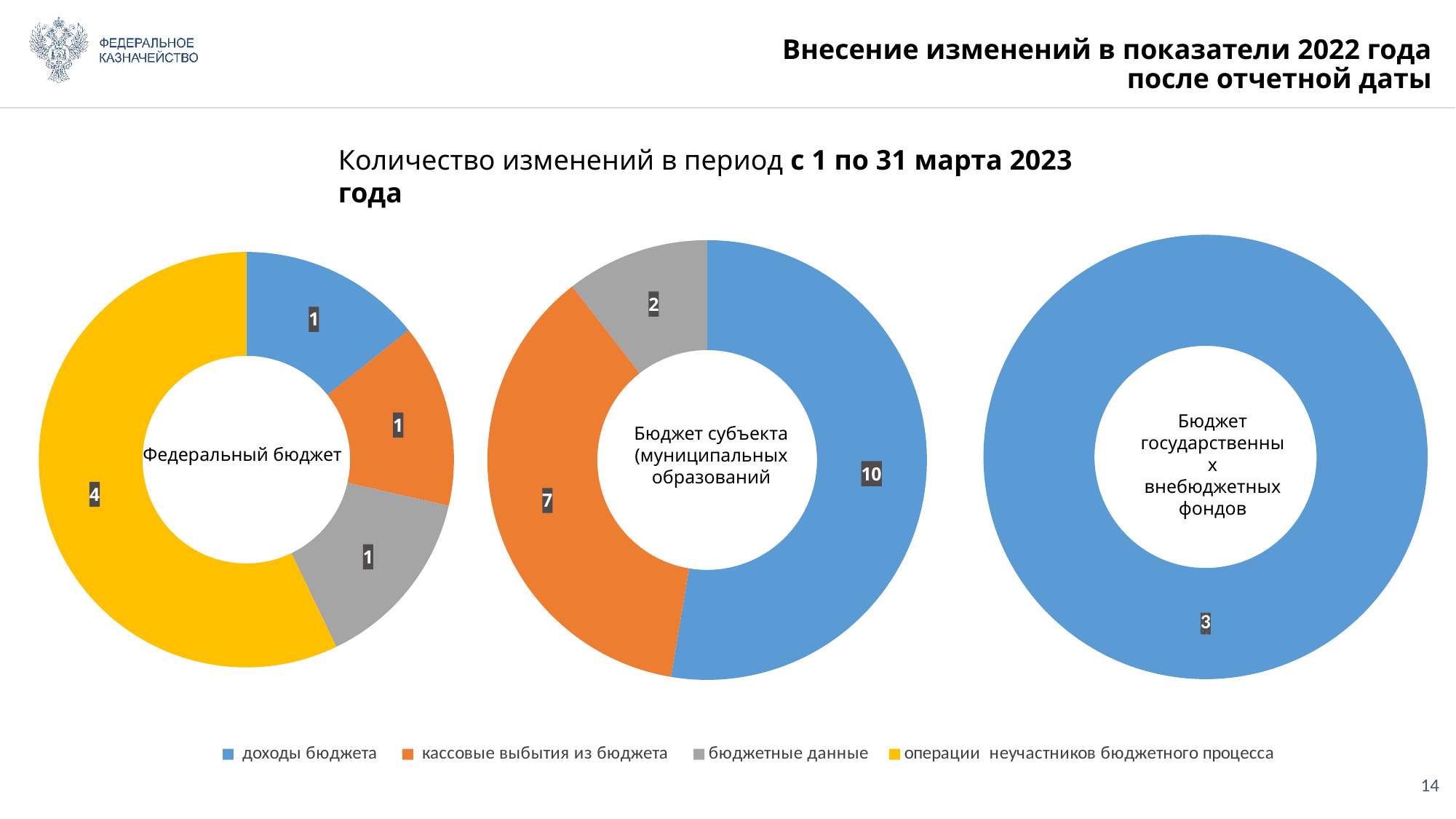
In the 'Федеральный бюджет' chart, which category has the largest value? операции неучастников бюджетного процесса What type of chart is used on this slide? Doughnut (pie) chart How many slices does the 'Бюджет субъекта (муниципальных образований)' chart have? 3 In the 'Федеральный бюджет' chart, what is the total of all the slices? 7 In the 'Федеральный бюджет' chart, what is the value for 'операции неучастников бюджетного процесса'? 4 In the 'Бюджет субъекта (муниципальных образований)' chart, what is the value for 'кассовые выбытия из бюджета'? 7 In the 'Бюджет субъекта (муниципальных образований)' chart, which category has the smallest value? бюджетные данные In the 'Бюджет государственных внебюджетных фондов' chart, what is the value for 'доходы бюджета'? 3 In the 'Бюджет субъекта (муниципальных образований)' chart, what is the difference between 'доходы бюджета' and 'кассовые выбытия из бюджета'? 3 In the 'Бюджет субъекта (муниципальных образований)' chart, what is the value for 'доходы бюджета'? 10 In the 'Бюджет субъекта (муниципальных образований)' chart, what is the total of all the slices? 19 How many series does the legend list? 4